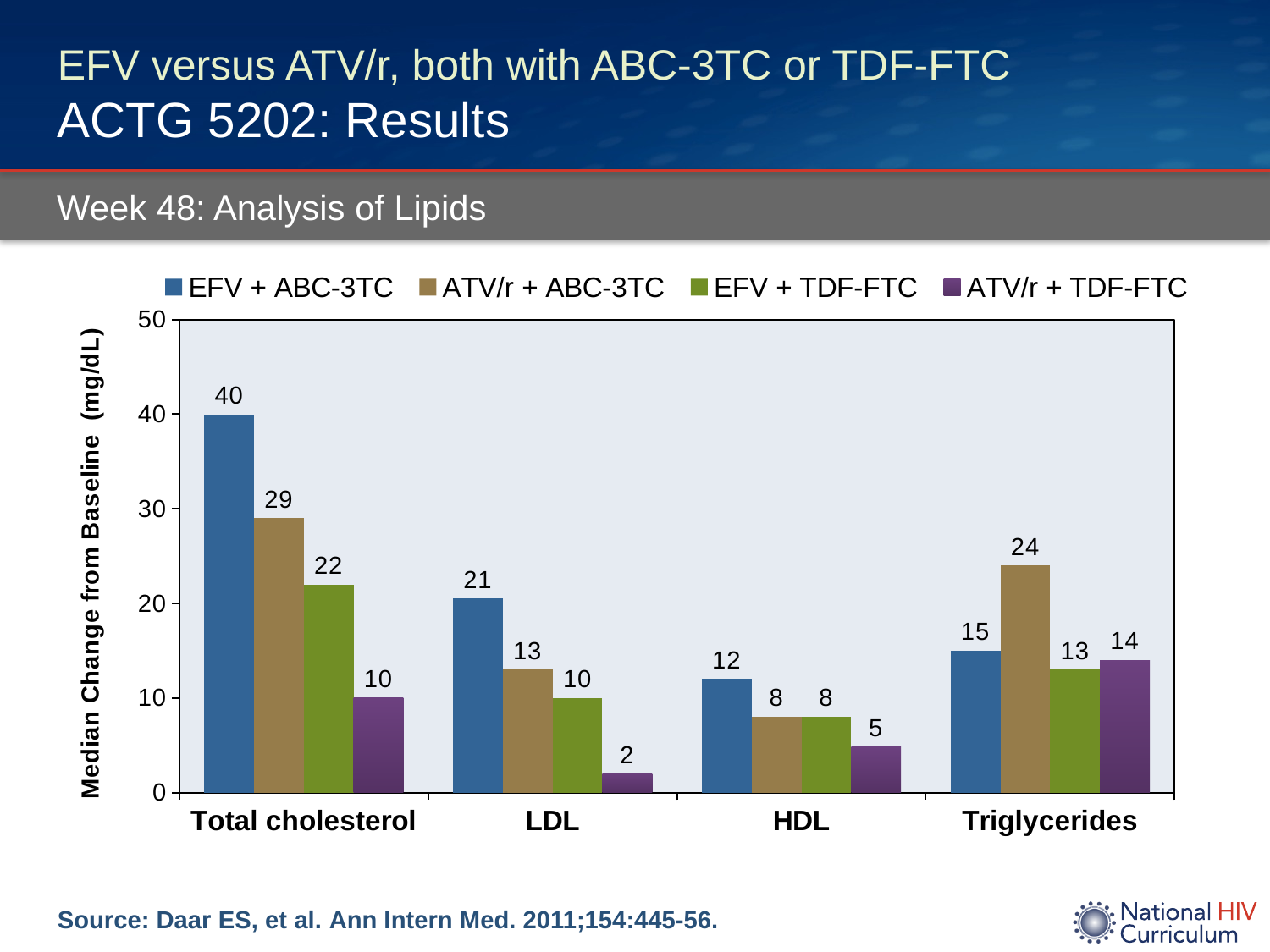
What is the median change from baseline in LDL for ATV/r + TDF-FTC? 2 What is the median change from baseline in triglycerides for ATV/r + ABC-3TC? 24 What is the difference between the total cholesterol change for EFV + ABC-3TC and ATV/r + ABC-3TC? 11 Which regimen has the lowest median change from baseline in HDL? ATV/r + TDF-FTC Which is larger: the LDL change for EFV + ABC-3TC or the triglycerides change for ATV/r + ABC-3TC? Triglycerides change for ATV/r + ABC-3TC What is the median change from baseline in total cholesterol for EFV + ABC-3TC? 40 How many series does the legend list? 4 How many lipid categories are shown on the x axis? 4 Is the HDL change for EFV + ABC-3TC greater or less than 10? greater What is the label of the y axis? Median Change from Baseline (mg/dL) Which regimen has the highest median change from baseline in total cholesterol? EFV + ABC-3TC What kind of chart is shown on the slide? Bar chart